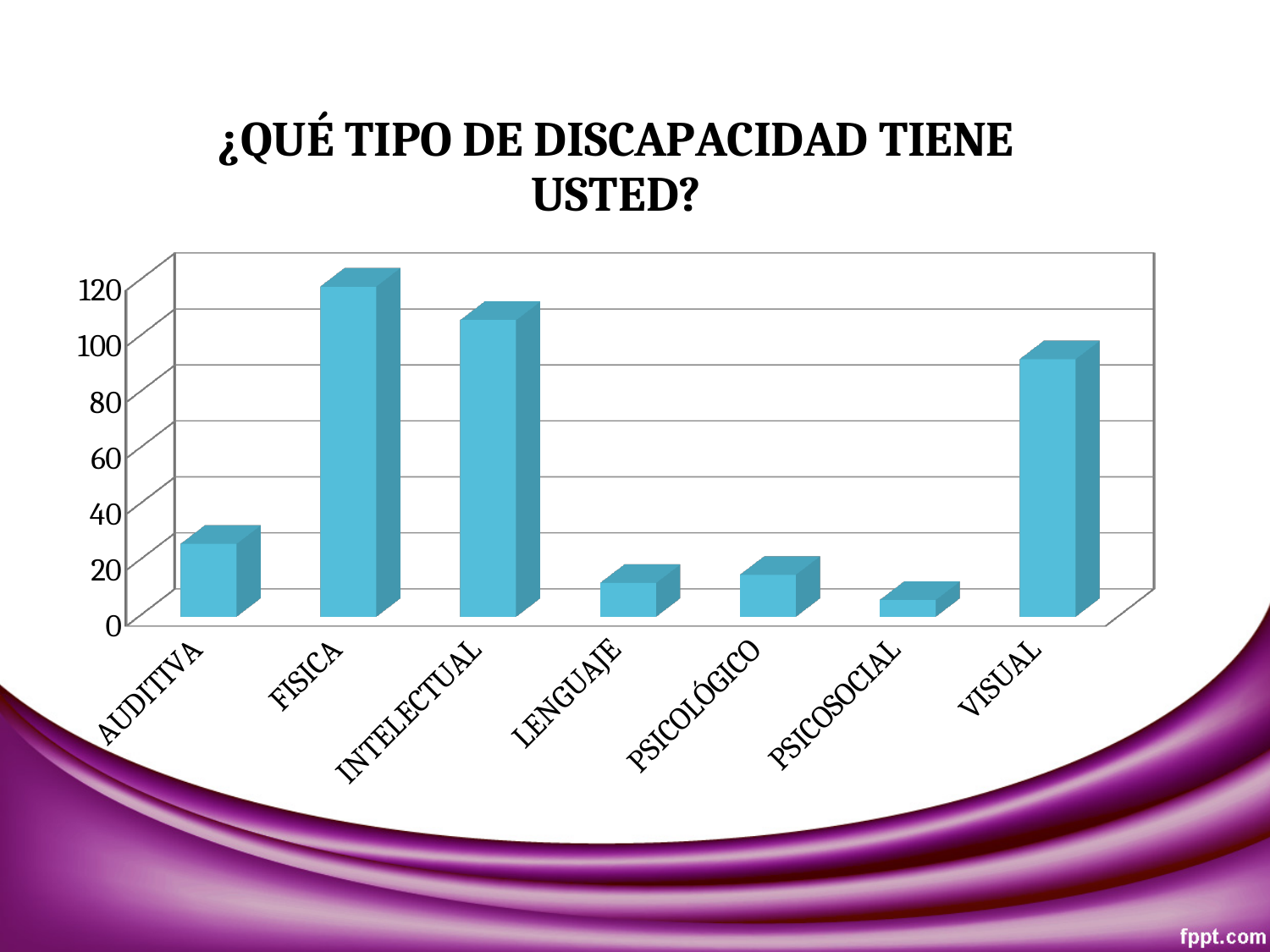
What is the title of the chart on the slide? ¿QUÉ TIPO DE DISCAPACIDAD TIENE USTED? Is the value for PSICOSOCIAL greater or less than 20? less Which category has the lowest bar in the chart? PSICOSOCIAL Is the value for AUDITIVA greater or less than 40? less What kind of chart is shown on the slide? bar chart Which is larger, the value for FISICA or the value for VISUAL? FISICA Is the value for VISUAL greater or less than 80? greater Which category has the highest bar in the chart? FISICA Which is larger, the value for AUDITIVA or the value for INTELECTUAL? INTELECTUAL How many categories are shown on the x axis of the chart? 7